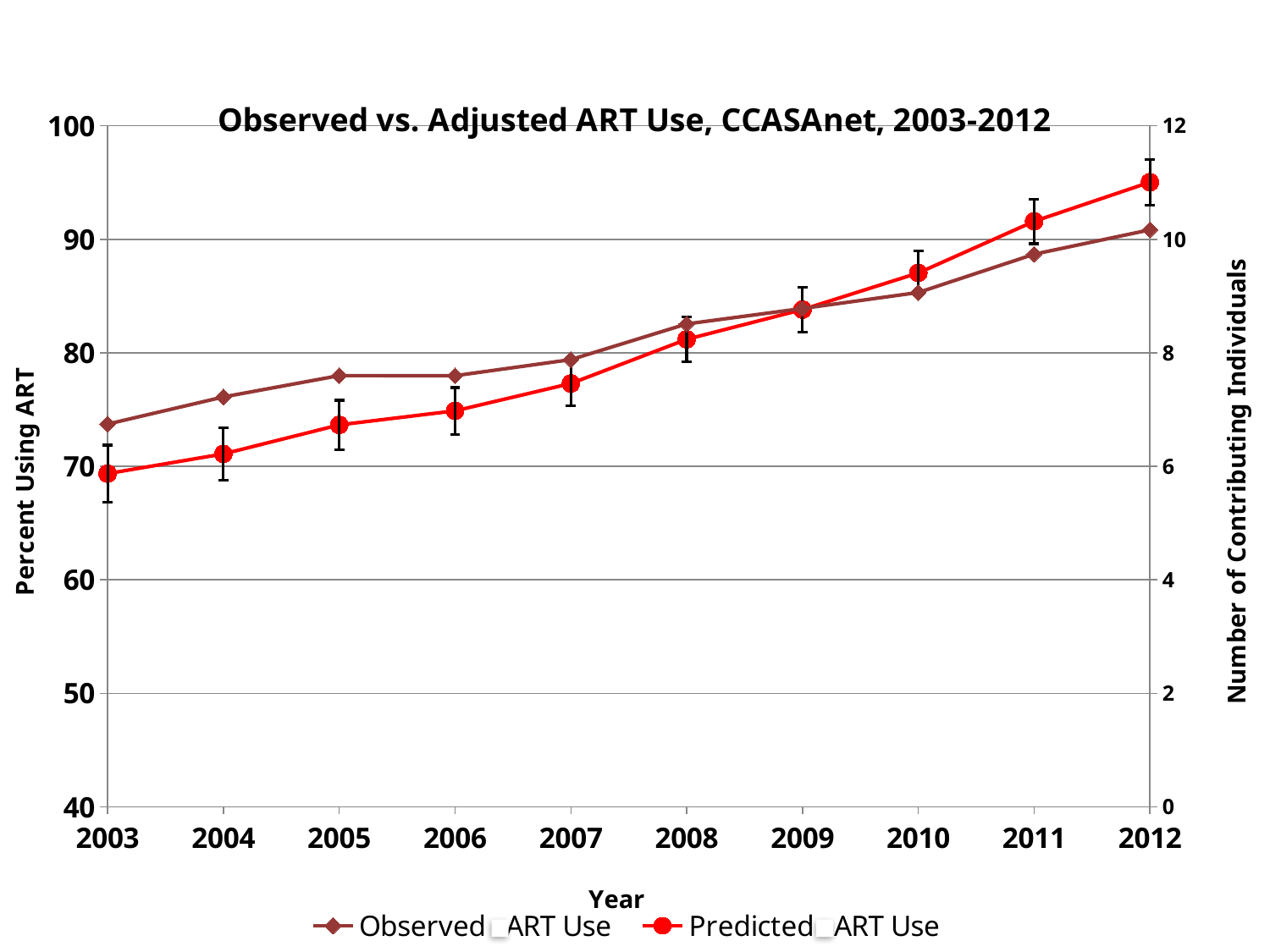
How many series does the legend list? 2 What kind of chart is shown on the slide? Line chart In which year is Observed ART Use lowest? 2003 In 2003, which is larger: Observed ART Use or Predicted ART Use? Observed ART Use How many years are plotted along the x axis? 10 In 2011, which is larger: Observed ART Use or Predicted ART Use? Predicted ART Use What is the title of the chart? Observed vs. Adjusted ART Use, CCASAnet, 2003-2012 Is the Predicted ART Use value for 2012 greater or less than 90? greater In which year is Predicted ART Use highest? 2012 Is the Observed ART Use value for 2003 greater or less than 70? greater Does Predicted ART Use rise or fall from 2003 to 2012? Rise Is the Predicted ART Use value for 2007 greater or less than 80? less